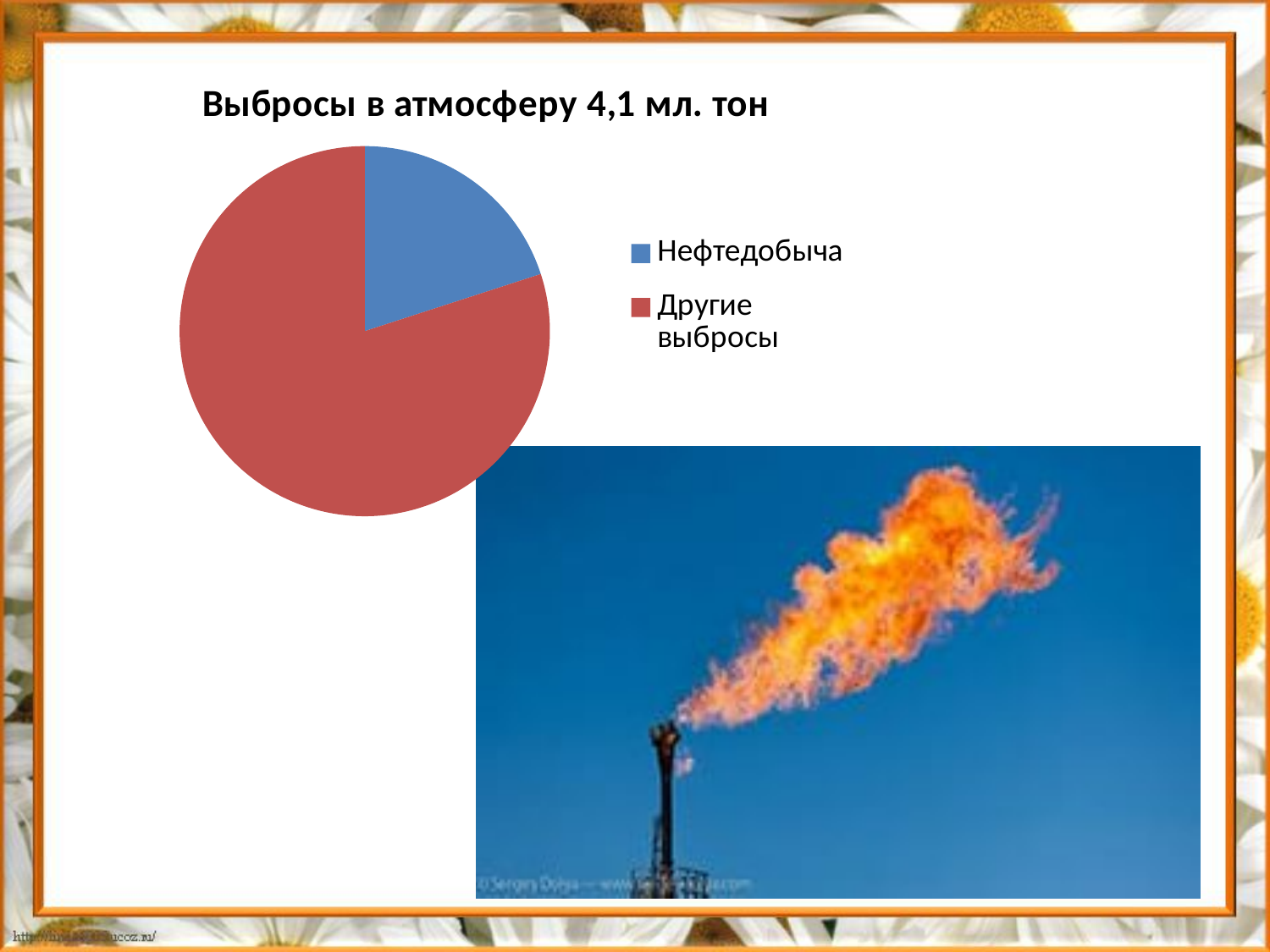
How many entries does the legend list? 2 Which category has the largest slice of the pie? Другие выбросы How many slices does the pie chart have? 2 Which category has the smallest slice of the pie? Нефтедобыча What colour is the slice for Нефтедобыча? blue What is the title of the chart? Выбросы в атмосферу 4,1 мл. тон Which slice is larger, Нефтедобыча or Другие выбросы? Другие выбросы What kind of chart is shown on the slide? pie chart